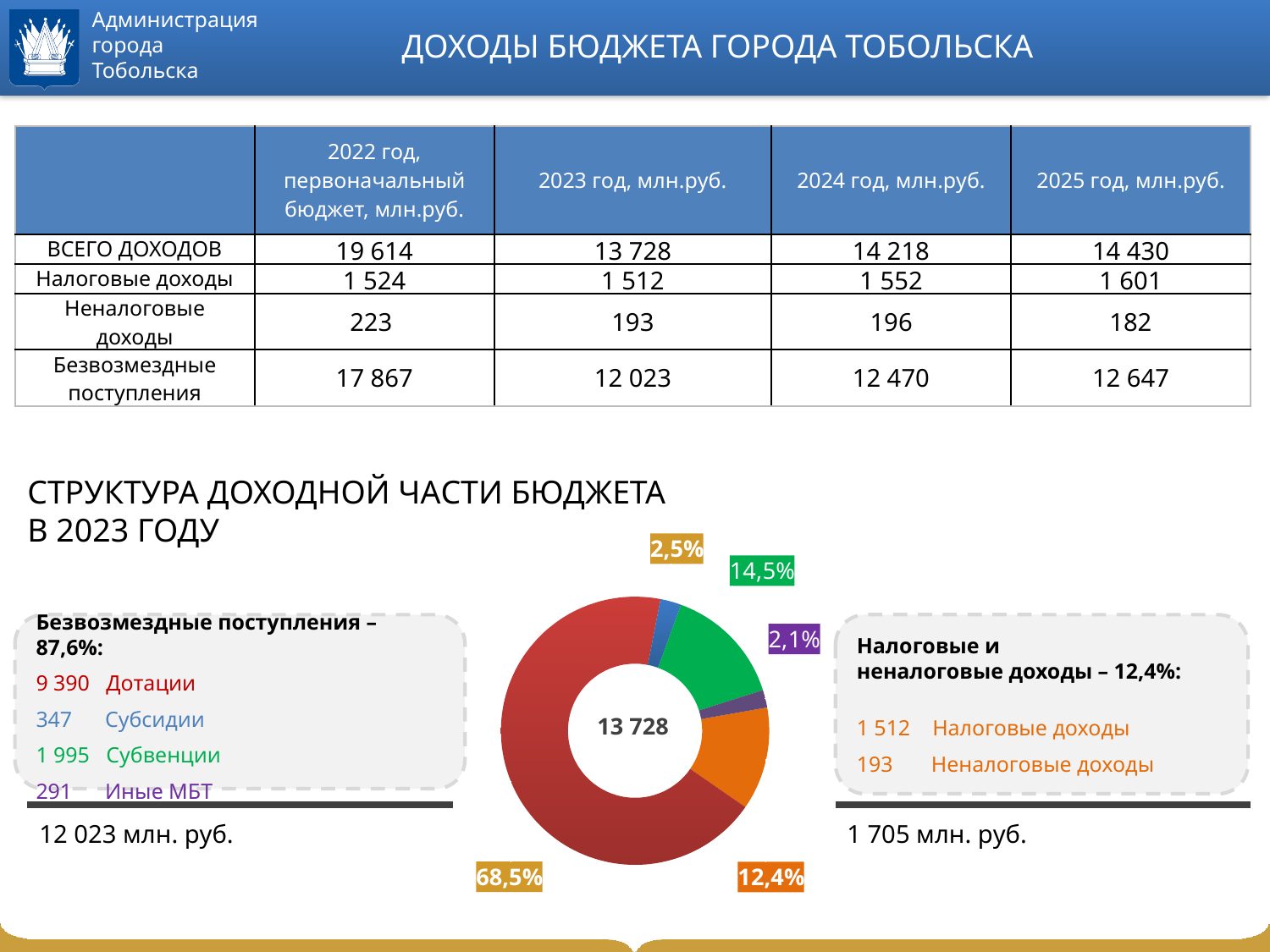
What percentage is shown for the orange slice of the donut chart? 12,4% How many slices does the donut chart have? 5 What percentage is shown for the blue slice of the donut chart? 2,5% What kind of chart is shown under the heading 'СТРУКТУРА ДОХОДНОЙ ЧАСТИ БЮДЖЕТА В 2023 ГОДУ'? Pie (donut) chart What is the largest percentage label shown on the donut chart? 68,5% By how many percentage points does the red slice (68,5%) exceed the green slice (14,5%) in the donut chart? 54 percentage points What value is printed in the centre of the donut chart? 13 728 What is the smallest percentage label shown on the donut chart? 2,1% What colour is the largest slice of the donut chart? Red What percentage is shown for the green slice of the donut chart? 14,5% Which slice of the donut chart is larger, the blue one (2,5%) or the purple one (2,1%)? The blue one (2,5%) What percentage is shown for the purple slice of the donut chart? 2,1%